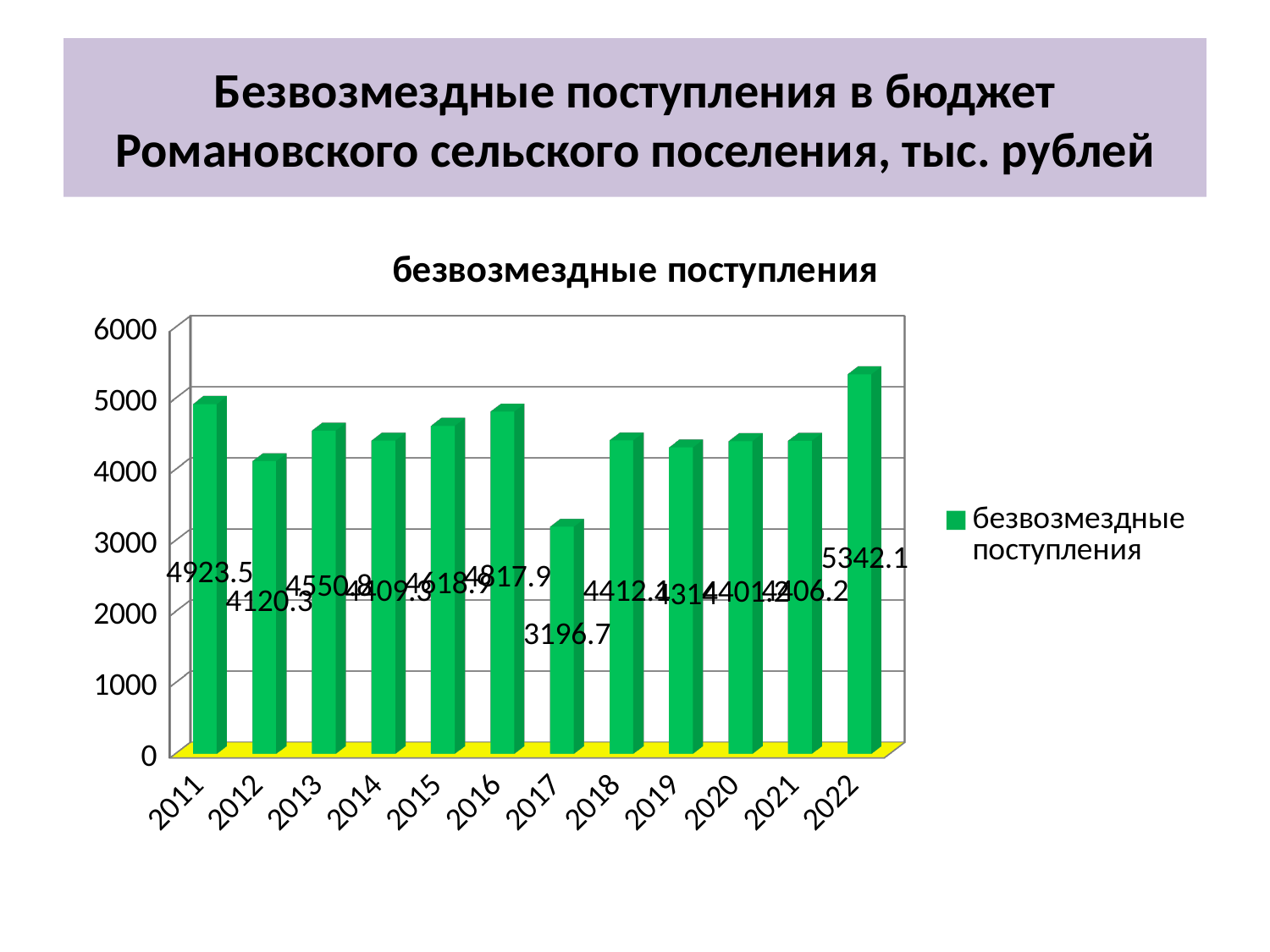
What is the difference between the values for 2022 and 2017? 2145.4 What is the value for 2022? 5342.1 Which year has the lowest value? 2017 How many years are shown on the x axis? 12 Which year has the highest value? 2022 Is the value for 2015 greater or less than 4000? greater How many series does the legend list? 1 What is the value for 2017? 3196.7 What is the value for 2012? 4120.3 What is the value for 2011? 4923.5 What kind of chart is shown? bar chart Which is larger, the value for 2011 or the value for 2016? 2011